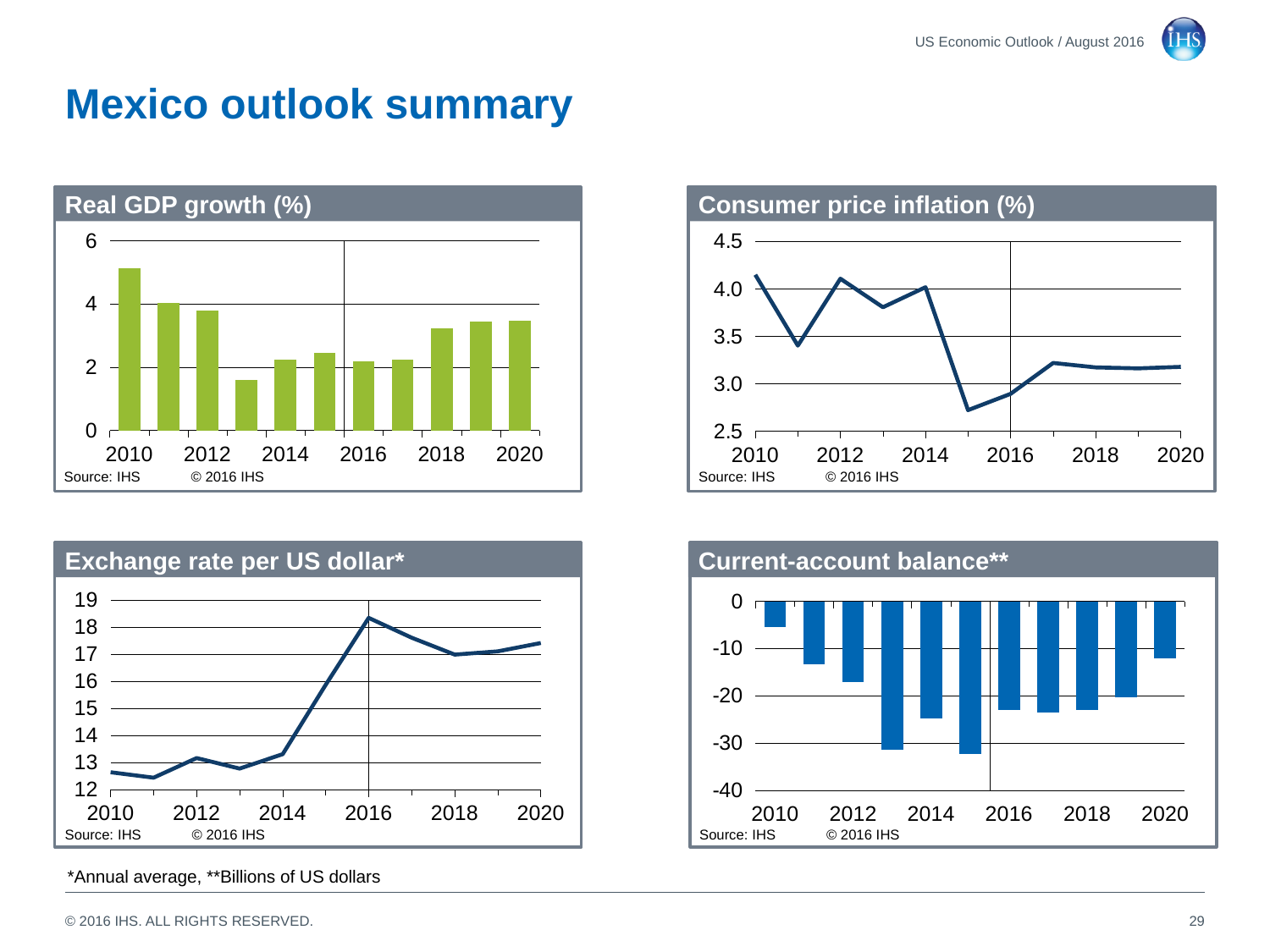
In the Consumer price inflation (%) chart, is the value for 2015 greater or less than 3.0? less In the Real GDP growth (%) chart, which year has the highest value? 2010 In the Real GDP growth (%) chart, is the value for 2010 greater or less than 4? greater In the Exchange rate per US dollar chart, which year has the highest value? 2016 What kind of chart is the Consumer price inflation (%) chart? line chart In the Consumer price inflation (%) chart, which year has the lowest value? 2015 In the Current-account balance chart, is the value for 2015 greater or less than -30? less What kind of chart is the Real GDP growth (%) chart? bar chart In the Real GDP growth (%) chart, which year has the lowest value? 2013 In the Exchange rate per US dollar chart, do values rise or fall from 2014 to 2016? rise How many bars are plotted in the Real GDP growth (%) chart? 11